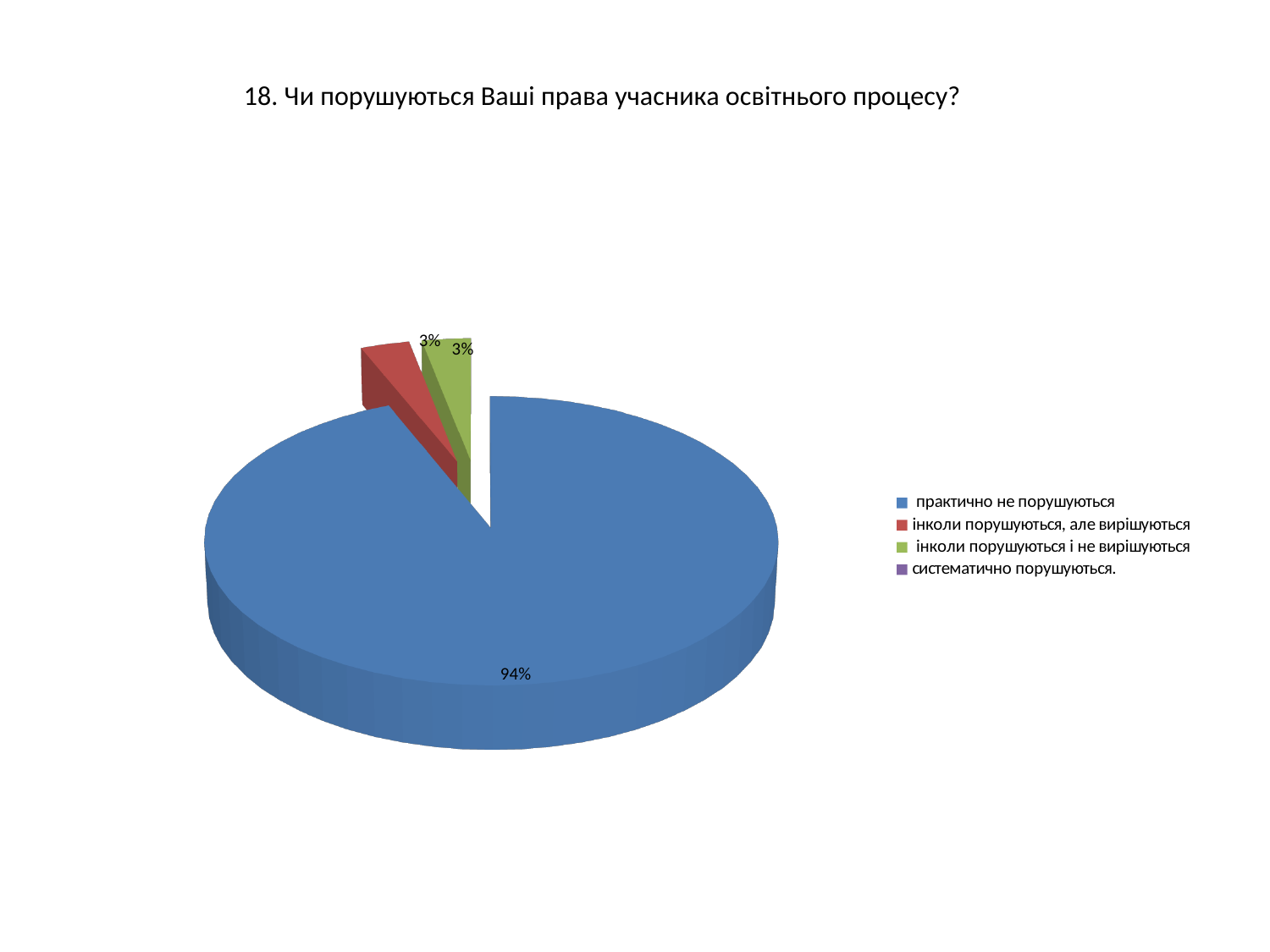
Which category has the largest slice of the pie? практично не порушуються What is the difference between the share for "практично не порушуються" and the share for "інколи порушуються, але вирішуються"? 91% How many entries does the legend list? 4 What colour is the slice for "практично не порушуються"? blue What is the value shown for "інколи порушуються, але вирішуються"? 3% Which is larger: the share for "практично не порушуються" or the share for "інколи порушуються і не вирішуються"? практично не порушуються What share of the pie does "практично не порушуються" take? 94% Is the share for "практично не порушуються" greater or less than 50%? greater What is the value shown for "інколи порушуються і не вирішуються"? 3% What kind of chart is shown on the slide? pie chart What is the title of the chart? 18. Чи порушуються Ваші права учасника освітнього процесу?